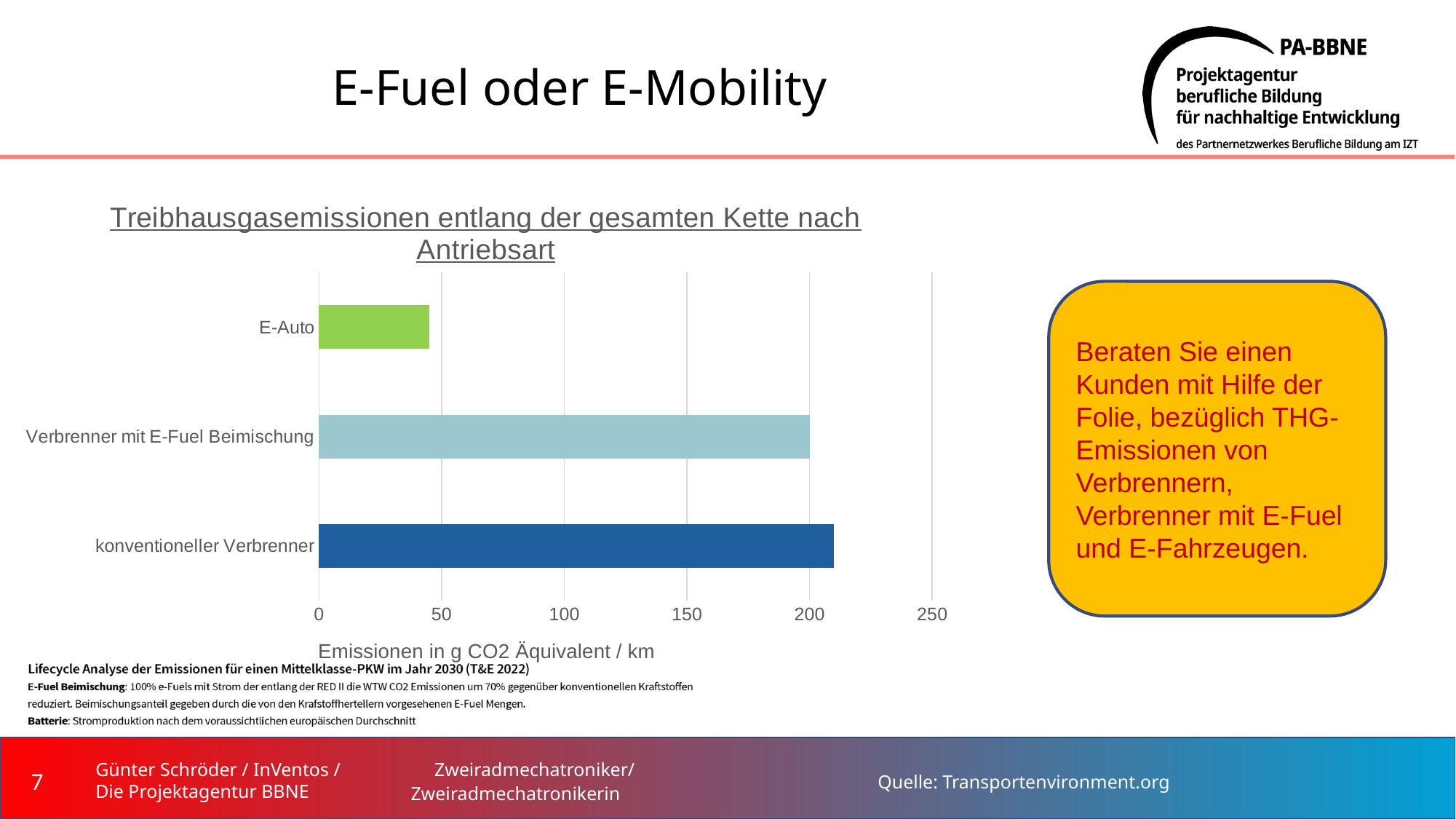
What is the emissions value for Verbrenner mit E-Fuel Beimischung? 200 What is the label of the horizontal axis of the chart? Emissionen in g CO2 Äquivalent / km Which has higher emissions, E-Auto or Verbrenner mit E-Fuel Beimischung? Verbrenner mit E-Fuel Beimischung Which drive type has the lowest emissions in the chart? E-Auto What kind of chart is shown on the slide? bar chart What is the title of the chart? Treibhausgasemissionen entlang der gesamten Kette nach Antriebsart Is the value for konventioneller Verbrenner greater or less than 200? greater Which drive type has the highest emissions in the chart? konventioneller Verbrenner Is the value for Verbrenner mit E-Fuel Beimischung greater or less than 150? greater Is the value for E-Auto greater or less than 50? less How many categories (drive types) are plotted in the chart? 3